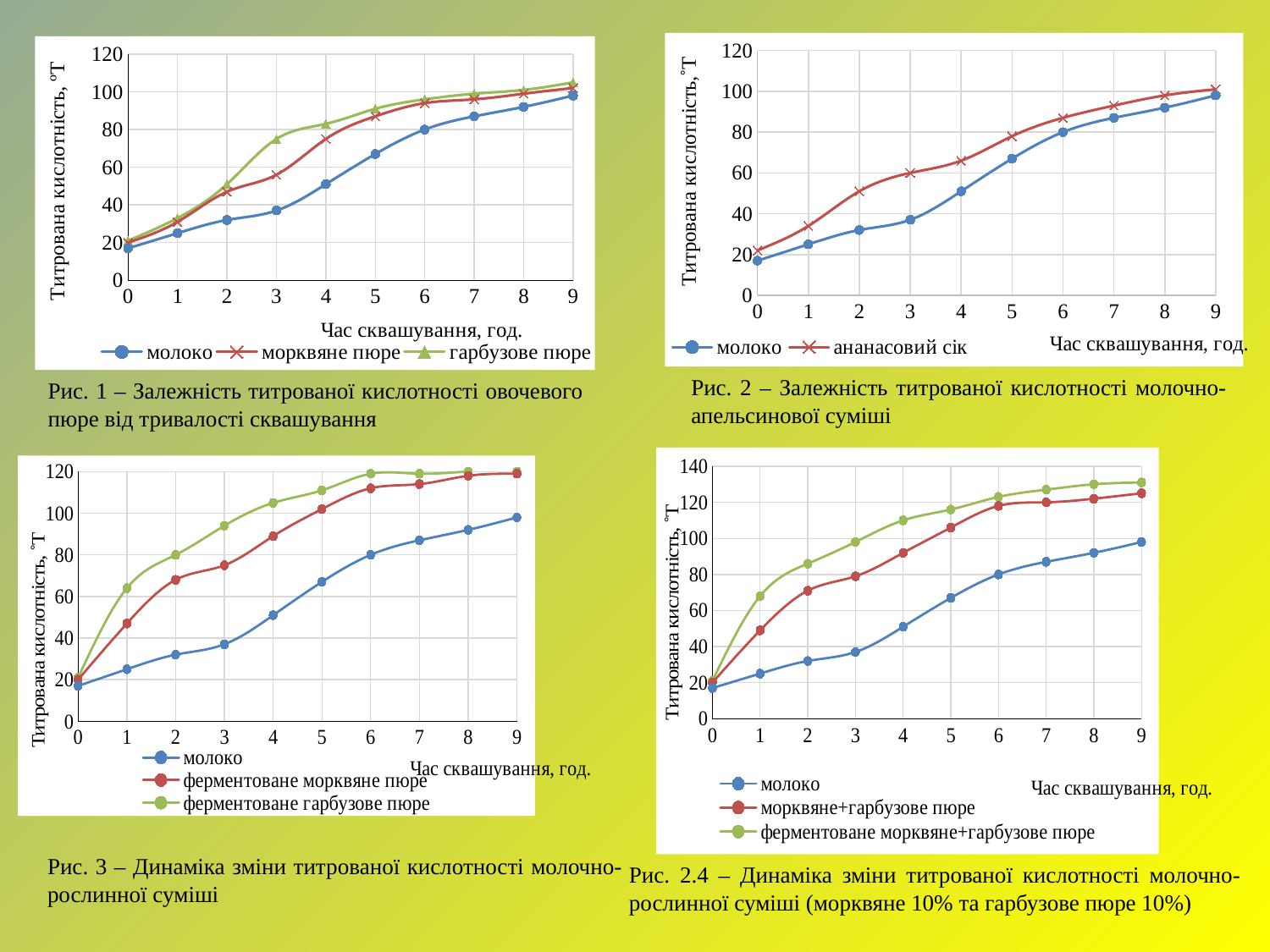
In the chart for Рис. 2 (top right), how many series does the legend list? 2 In the chart for Рис. 1 (top left), how many series does the legend list? 3 In the chart for Рис. 2 (top right), is the value for ананасовий сік at hour 2 greater or less than 40? greater In the chart for Рис. 1 (top left), which series has the highest value at hour 3? гарбузове пюре In the chart for Рис. 2 (top right), which series is higher at hour 3, молоко or ананасовий сік? ананасовий сік What kind of chart is shown for Рис. 2.4 (bottom right)? line chart In the chart for Рис. 3 (bottom left), how many time points are plotted along the x axis for each series? 10 In the chart for Рис. 3 (bottom left), which series has the lowest value at hour 4? молоко In the chart for Рис. 3 (bottom left), is the value for ферментоване гарбузове пюре at hour 2 greater or less than 60? greater In the chart for Рис. 2.4 (bottom right), is the value for ферментоване морквяне+гарбузове пюре at hour 9 greater or less than 120? greater In the chart for Рис. 2.4 (bottom right), do the values for молоко rise or fall as the fermentation time increases? rise